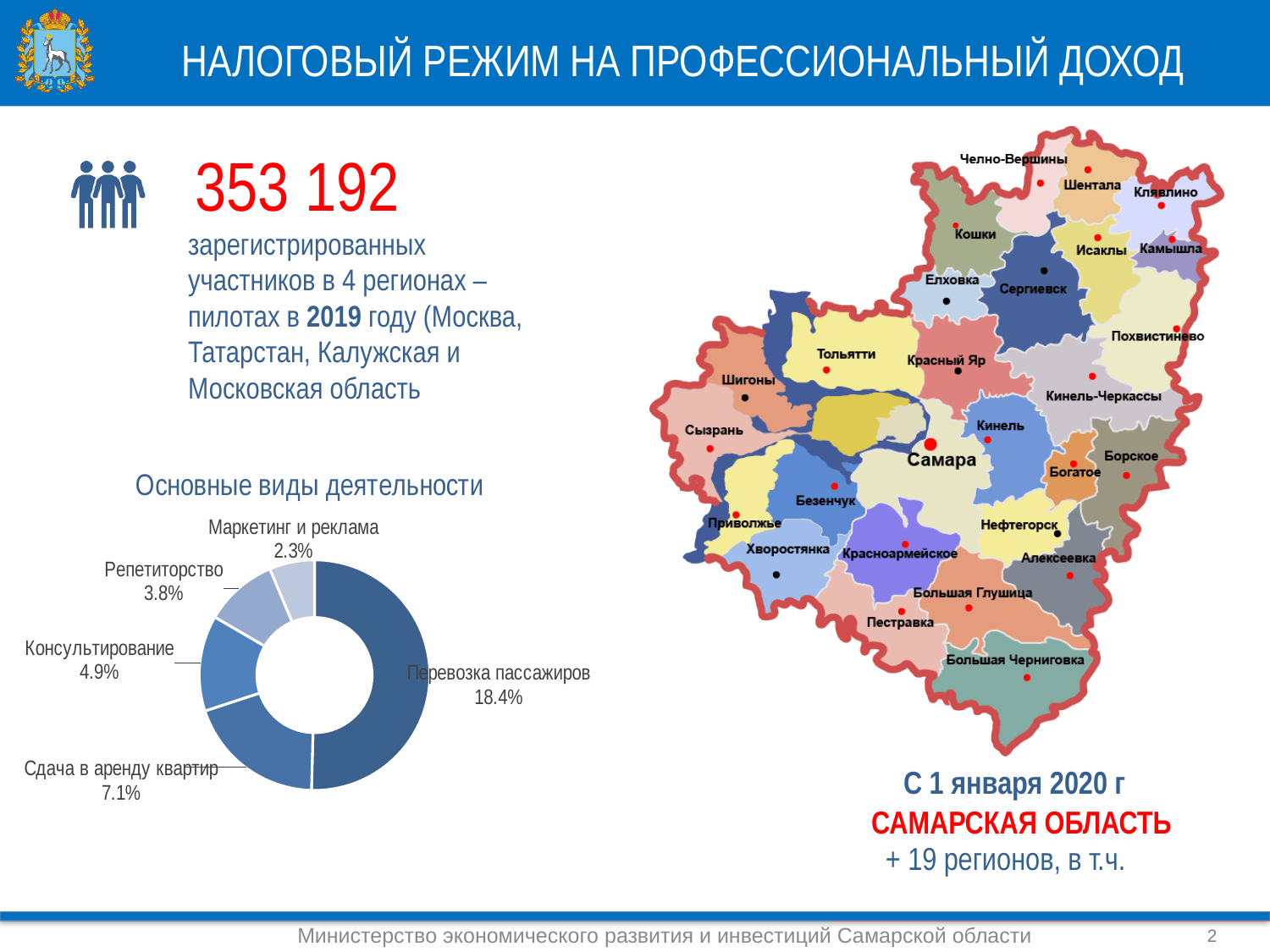
What percentage is shown for «Консультирование» in the chart? 4.9% Which activity has the largest share in the chart? Перевозка пассажиров Which activity has the smallest share in the chart? Маркетинг и реклама What percentage is shown for «Перевозка пассажиров» in the chart? 18.4% What percentage is shown for «Репетиторство» in the chart? 3.8% How many activity categories are labelled in the chart? 5 What percentage is shown for «Маркетинг и реклама» in the chart? 2.3% What percentage is shown for «Сдача в аренду квартир» in the chart? 7.1% What is the difference in percentage points between «Перевозка пассажиров» and «Сдача в аренду квартир»? 11.3 Which is larger in the chart: «Консультирование» or «Репетиторство»? Консультирование What kind of chart is shown under the heading «Основные виды деятельности»? Doughnut (pie) chart What is the title of the chart on the slide? Основные виды деятельности